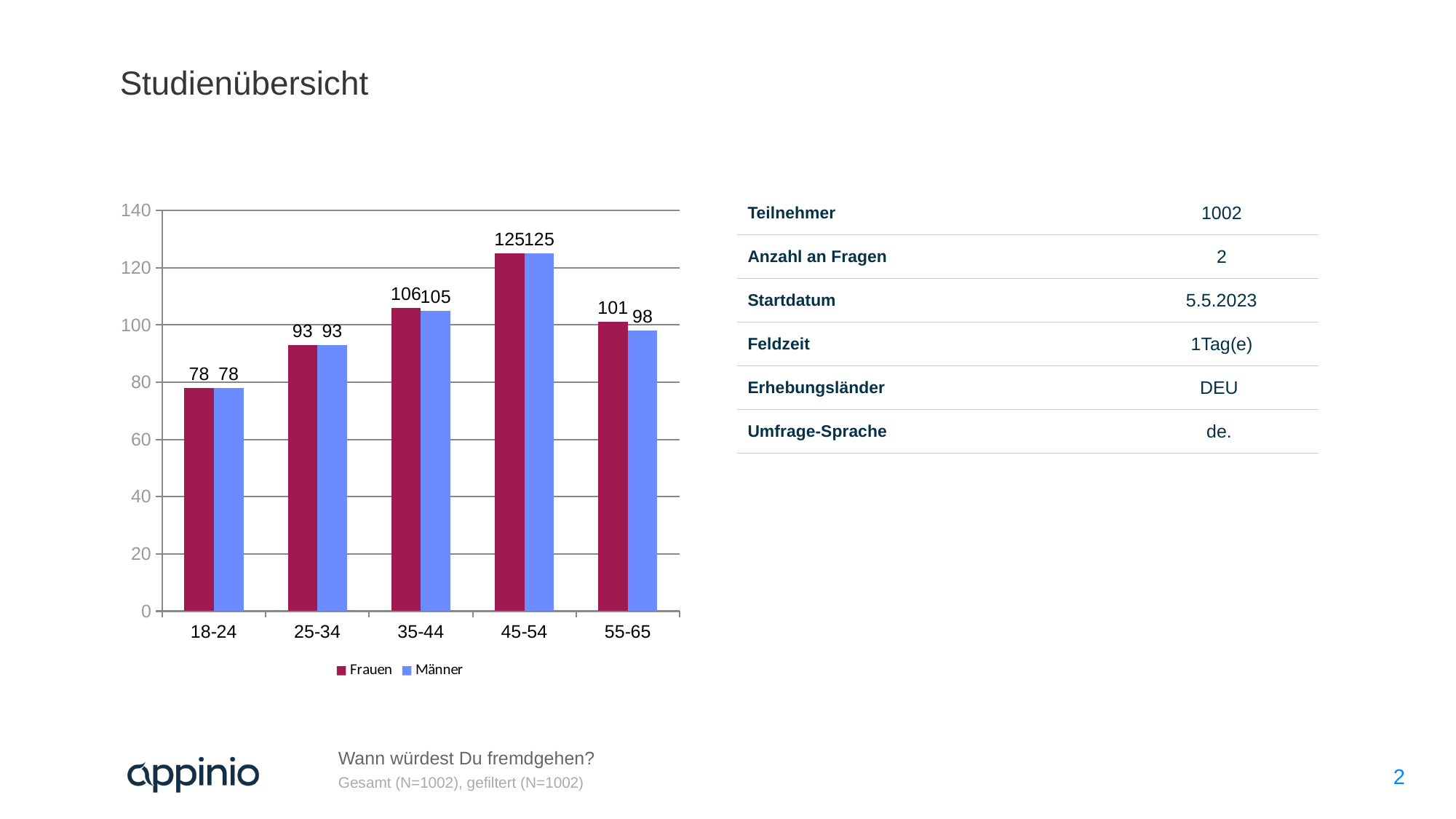
How many age groups are shown on the x axis? 5 Which is larger: the Männer value for 35-44 or the Männer value for 55-65? 35-44 Which age group has the highest value for Männer? 45-54 What is the value for Frauen in the 18-24 age group? 78 Which age group has the lowest value for Frauen? 18-24 Which series is shown in blue in the legend? Männer How many series does the legend list? 2 What is the difference between the Frauen and Männer values in the 55-65 age group? 3 What kind of chart is shown on the slide? bar chart What is the difference between the Frauen values for 45-54 and 25-34? 32 What is the value for Frauen in the 35-44 age group? 106 What is the value for Männer in the 55-65 age group? 98